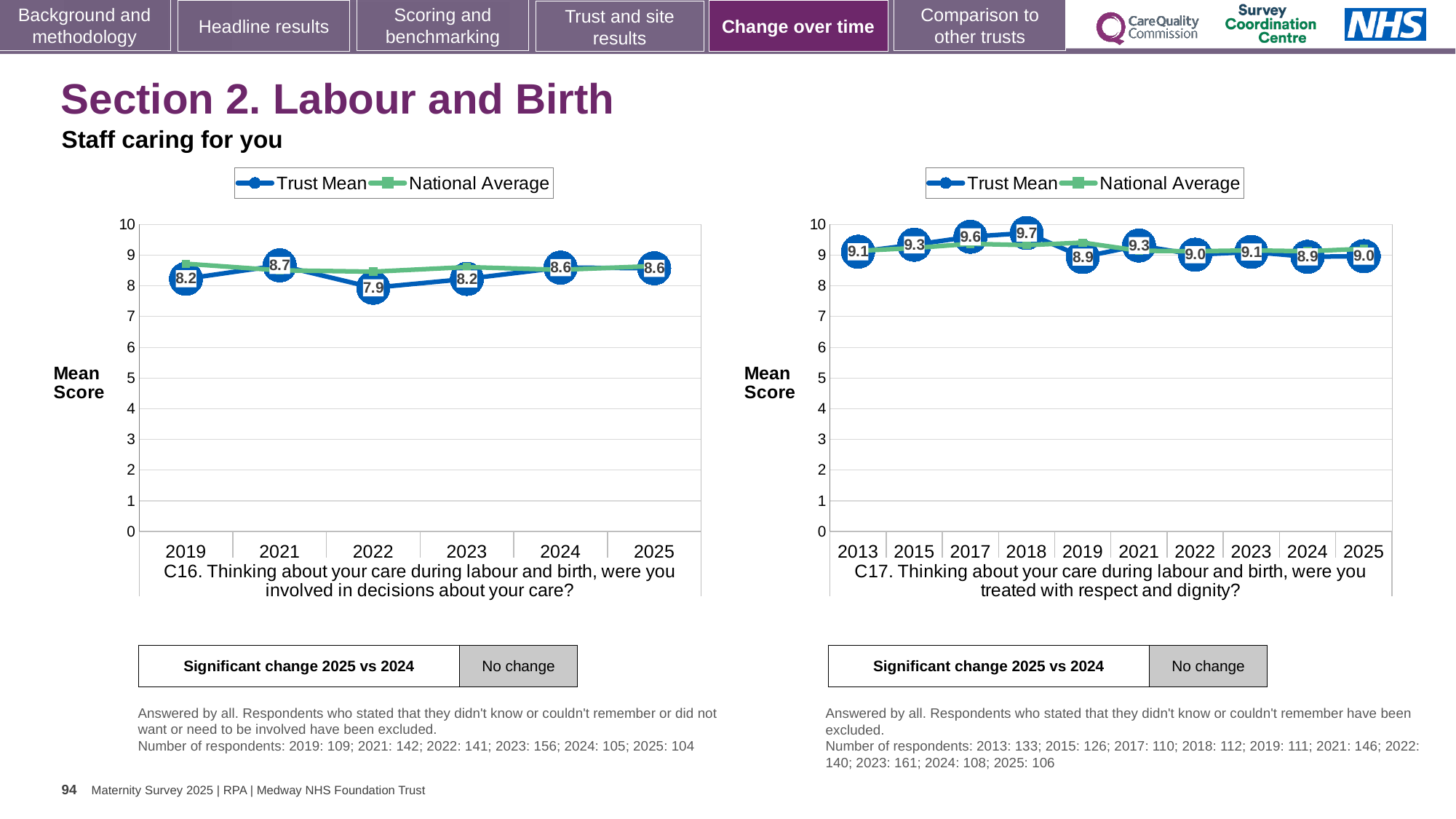
In the left chart (C16), what is the Trust Mean for 2021? 8.7 In the right chart (C17), how many years are shown on the x axis? 10 In the right chart (C17), what is the Trust Mean for 2025? 9.0 In the left chart (C16), which year has the lowest Trust Mean? 2022 In the left chart (C16), what is the Trust Mean for 2022? 7.9 In the right chart (C17), what is the Trust Mean for 2018? 9.7 How many series does the legend of the left chart (C16) list? 2 In the left chart (C16), how many years are shown on the x axis? 6 In the left chart (C16), what is the difference between the Trust Mean for 2021 and 2022? 0.8 In the left chart (C16), which year has the highest Trust Mean? 2021 In the right chart (C17), is the Trust Mean for 2019 or 2021 larger? 2021 In the right chart (C17), which year has the highest Trust Mean? 2018